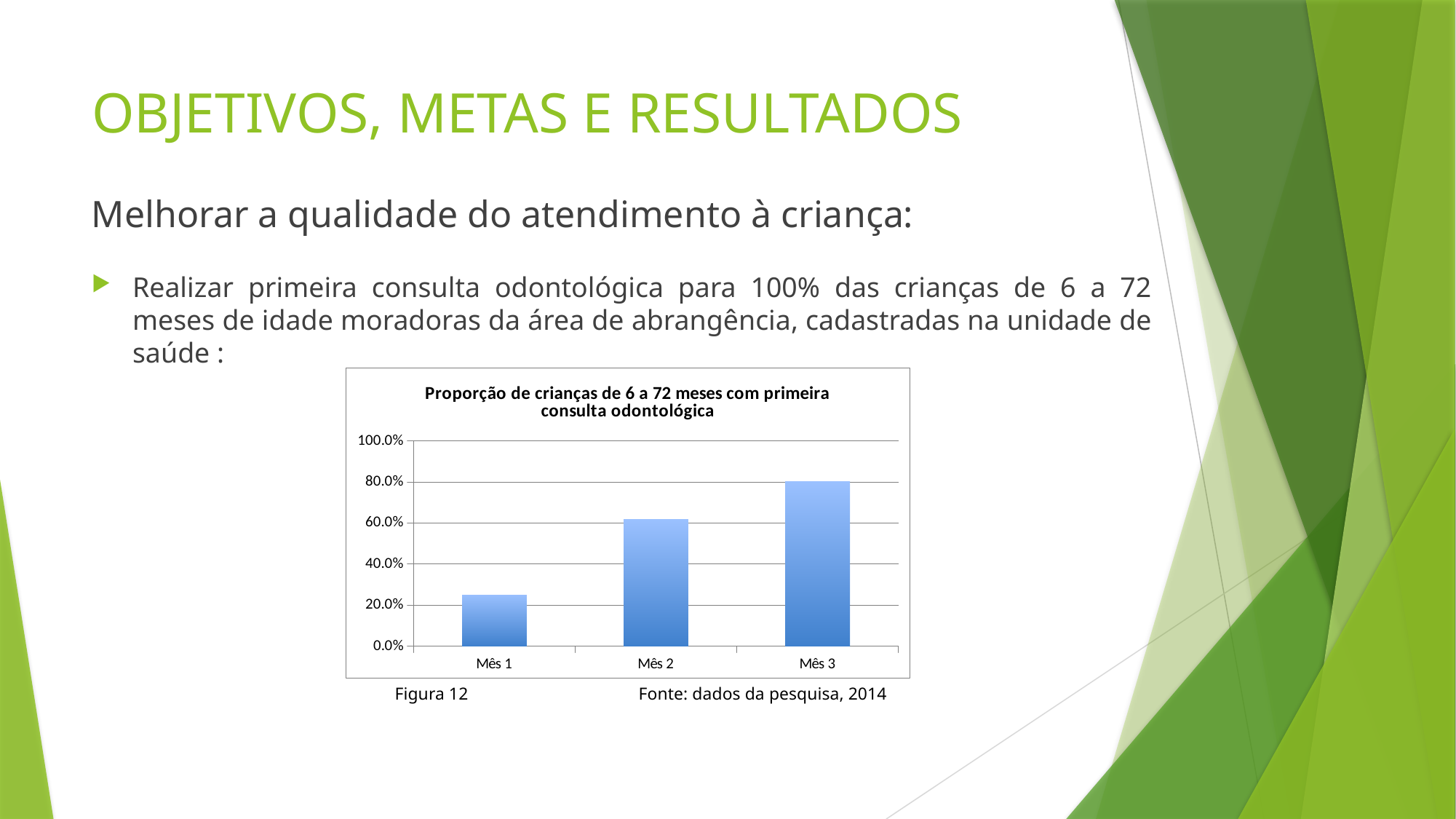
How many months (categories) are plotted on the chart? 3 Is the value for Mês 1 greater or less than 40.0%? less Is the value for Mês 1 greater or less than 20.0%? greater Is the value for Mês 3 greater or less than 60.0%? greater Which month has the highest proportion of children with a first dental consultation? Mês 3 What is the title of the chart? Proporção de crianças de 6 a 72 meses com primeira consulta odontológica What kind of chart is shown on the slide? bar chart Which month has the lowest proportion of children with a first dental consultation? Mês 1 Which is larger, the value for Mês 2 or the value for Mês 1? Mês 2 Do the values rise or fall from Mês 1 to Mês 3? rise